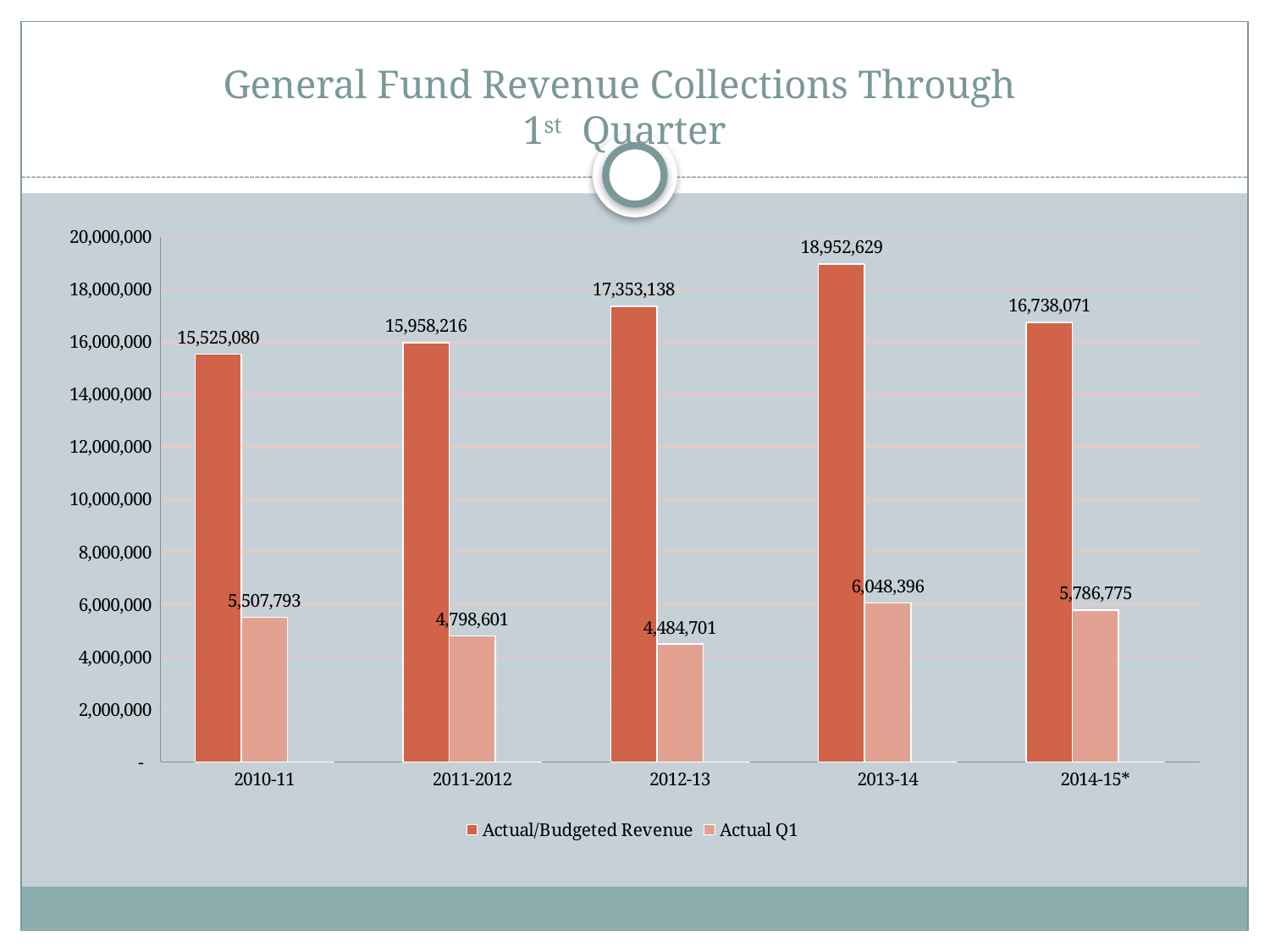
What is the Actual/Budgeted Revenue value for 2010-11? 15,525,080 What is the Actual Q1 value for 2012-13? 4,484,701 Which is larger: the Actual Q1 value for 2013-14 or for 2014-15*? 2013-14 Is the Actual/Budgeted Revenue for 2012-13 greater or less than 16,000,000? greater Which year has the highest Actual/Budgeted Revenue? 2013-14 What is the difference between Actual/Budgeted Revenue and Actual Q1 for 2013-14? 12,904,233 How many series does the legend list? 2 What type of chart is shown on the slide? Bar chart How much higher is the Actual Q1 value for 2010-11 than for 2011-2012? 709,192 What is the Actual/Budgeted Revenue value for 2013-14? 18,952,629 How many fiscal years are shown on the x axis? 5 Which year has the lowest Actual Q1 value? 2012-13